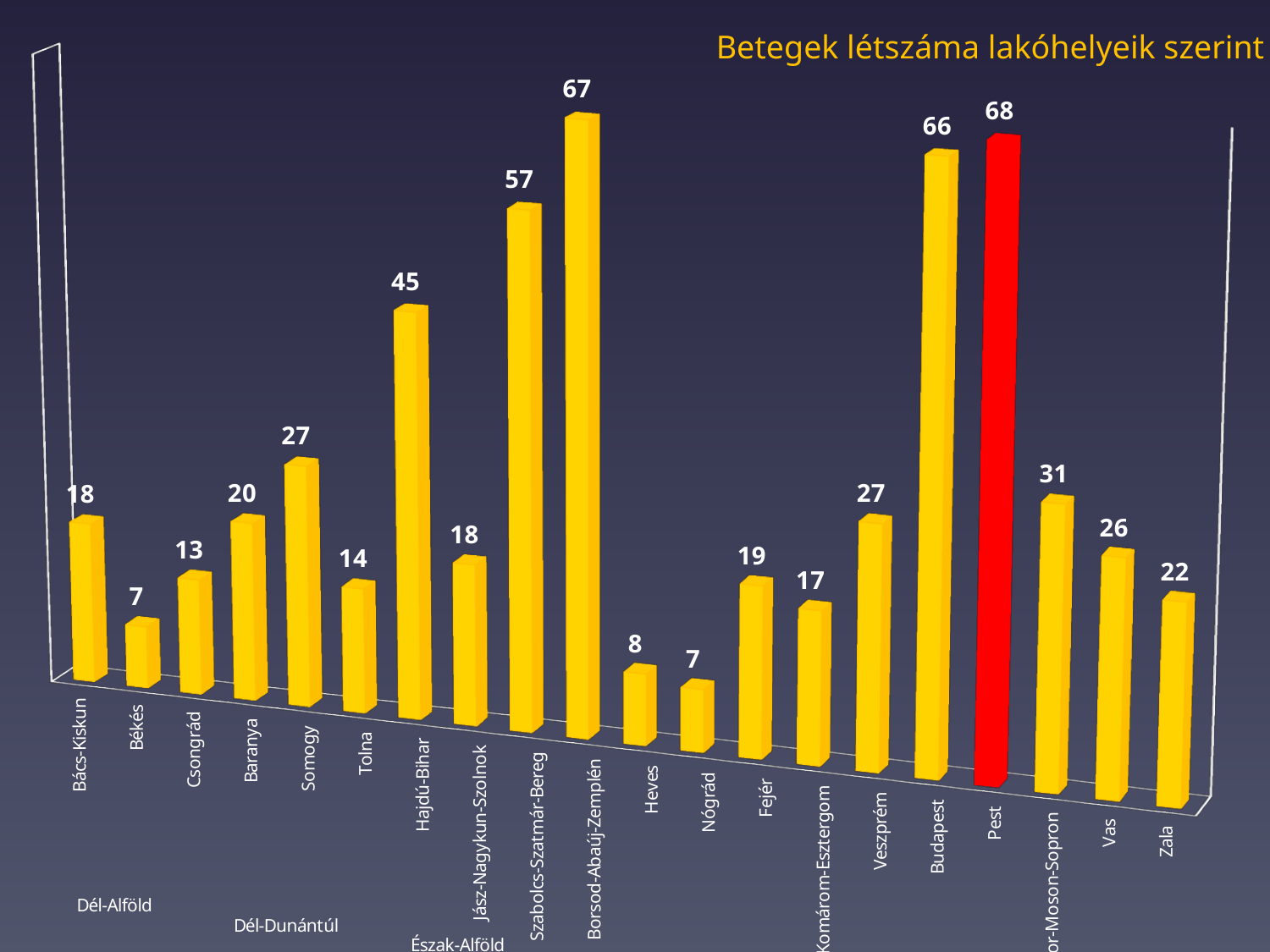
How many categories are shown on the chart? 20 What kind of chart is shown on the slide? Bar chart Which category has the highest value? Pest What is the value for Hajdú-Bihar? 45 What is the value for Veszprém? 27 What is the difference between the values for Pest and Budapest? 2 Which bar is coloured red instead of yellow? Pest Which is larger, the value for Somogy or the value for Baranya? Somogy What is the value for Budapest? 66 What is the value for Borsod-Abaúj-Zemplén? 67 What is the difference between the values for Szabolcs-Szatmár-Bereg and Tolna? 43 Which is larger, the value for Vas or the value for Zala? Vas